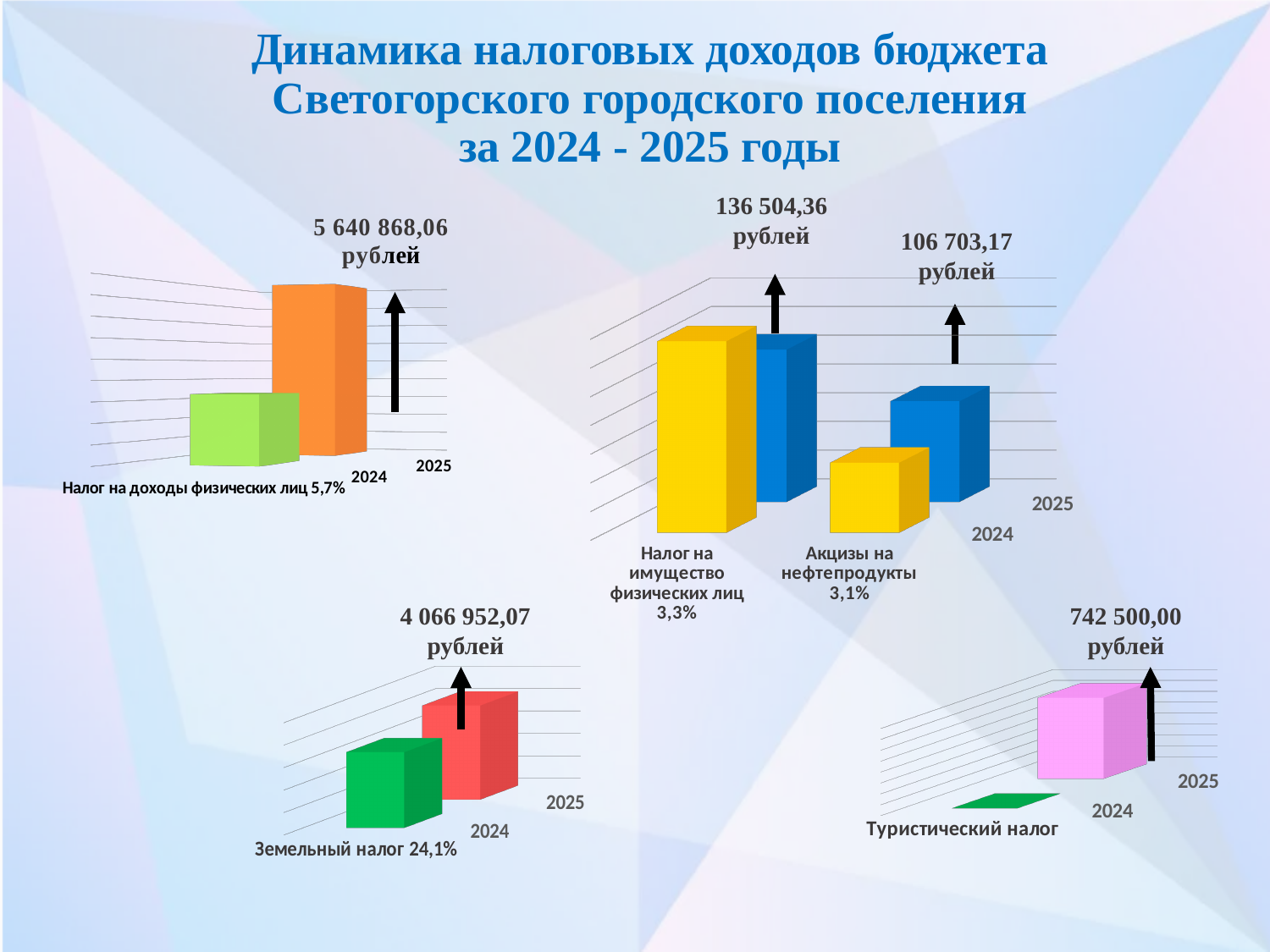
How many tax categories are shown in the top-right chart (Налог на имущество физических лиц and Акцизы на нефтепродукты)? 2 In the bottom-left chart (Земельный налог), which year has the taller bar, 2024 or 2025? 2025 What amount is printed above the top-right chart for Акцизы на нефтепродукты? 106 703,17 рублей In the top-right chart, for Акцизы на нефтепродукты, which year has the taller bar, 2024 or 2025? 2025 What amount is printed above the top-left chart for Налог на доходы физических лиц? 5 640 868,06 рублей In the top-right chart, which category has the taller 2024 bar, Налог на имущество физических лиц or Акцизы на нефтепродукты? Налог на имущество физических лиц In the bottom-left chart (Земельный налог), do the values rise or fall from 2024 to 2025? rise How many charts are shown on the slide? 4 In the top-left chart (Налог на доходы физических лиц), do the values rise or fall from 2024 to 2025? rise What kind of chart is used for Налог на доходы физических лиц in the top-left of the slide? bar chart